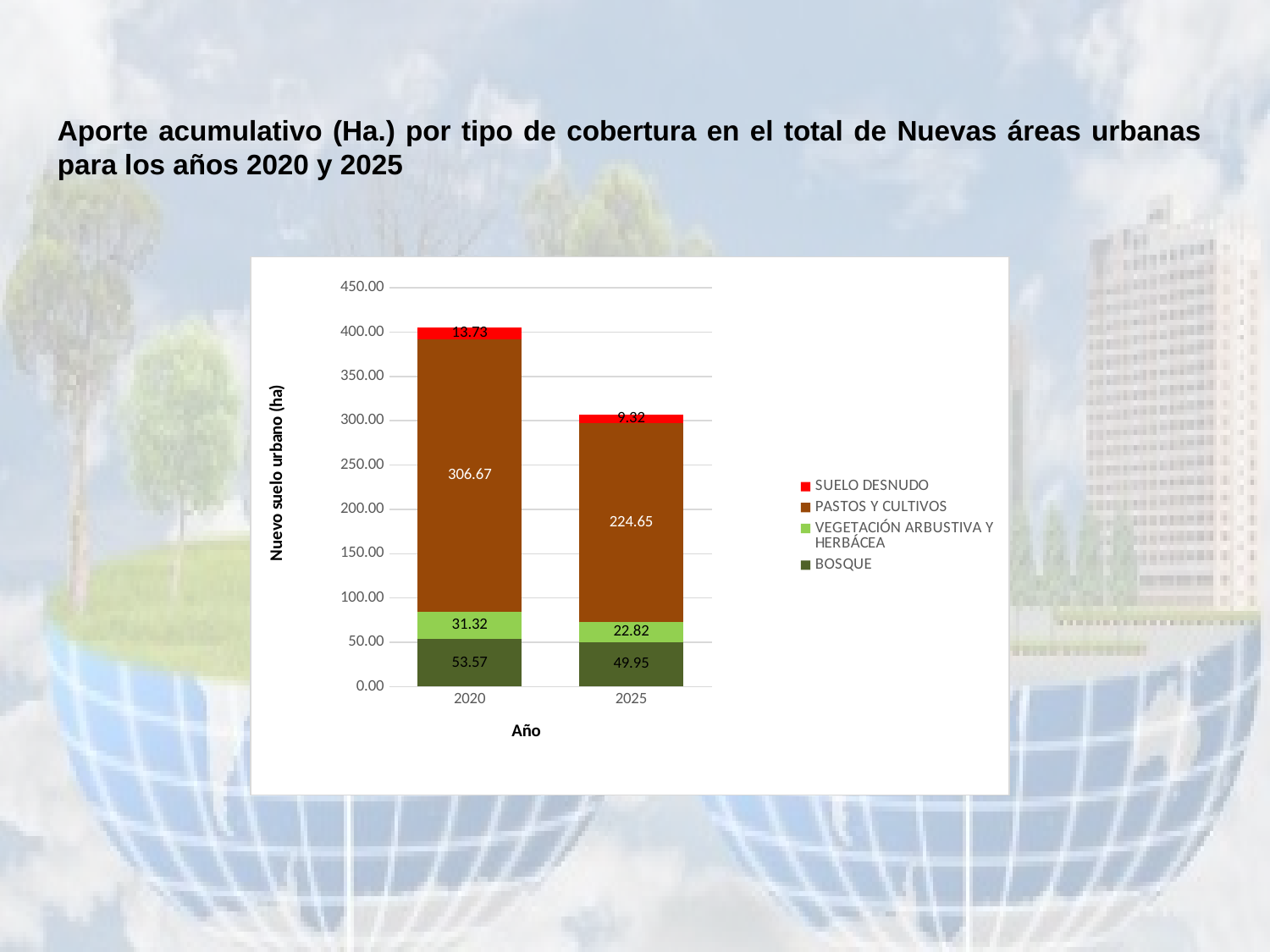
What type of chart is shown on the slide? Stacked bar chart What is the value for VEGETACIÓN ARBUSTIVA Y HERBÁCEA in 2025? 22.82 Which series contributes the most in 2025? PASTOS Y CULTIVOS What is the value for PASTOS Y CULTIVOS in 2020? 306.67 What is the value for SUELO DESNUDO in 2020? 13.73 What is the total of the stacked bar for 2020? 405.29 Which series contributes the least in 2020? SUELO DESNUDO What is the total of the stacked bar for 2025? 306.74 How many years are shown on the x axis? 2 How many series does the legend list? 4 What is the value for BOSQUE in 2025? 49.95 What is the difference between the PASTOS Y CULTIVOS values for 2020 and 2025? 82.02